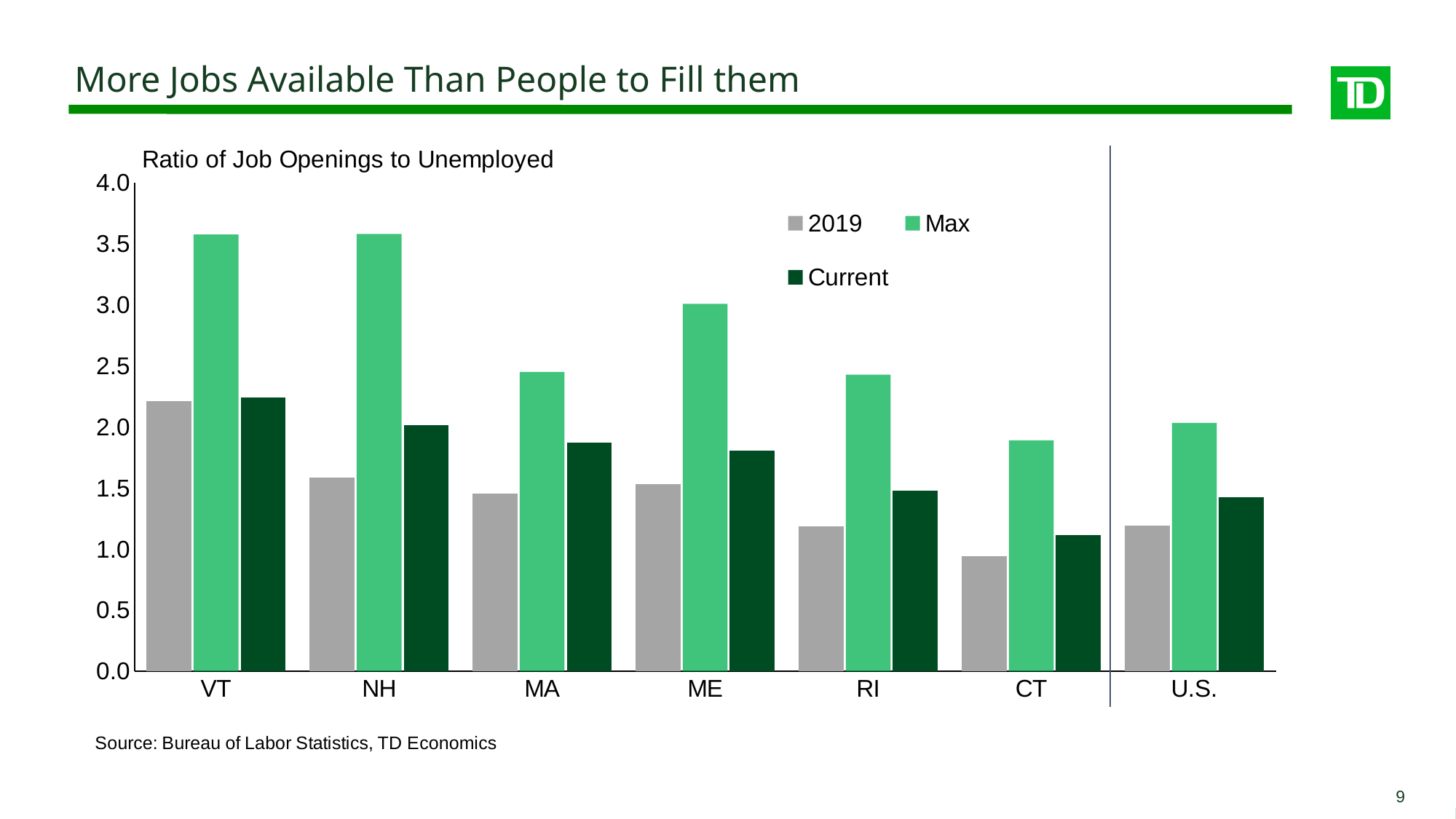
Is the Current value for U.S. greater or less than 1.5? less What is the title of the chart? Ratio of Job Openings to Unemployed Which category has the lowest value for the Current series? CT Which category has the highest value for the Current series? VT Is the Current value for MA greater or less than 1.5? greater How many series does the legend list? 3 For NH, which is larger: the Current value or the 2019 value? Current What kind of chart is shown on the slide? Bar chart Is the Max value for VT greater or less than 3.0? greater Which category has the lowest value for the 2019 series? CT How many categories are shown on the x axis? 7